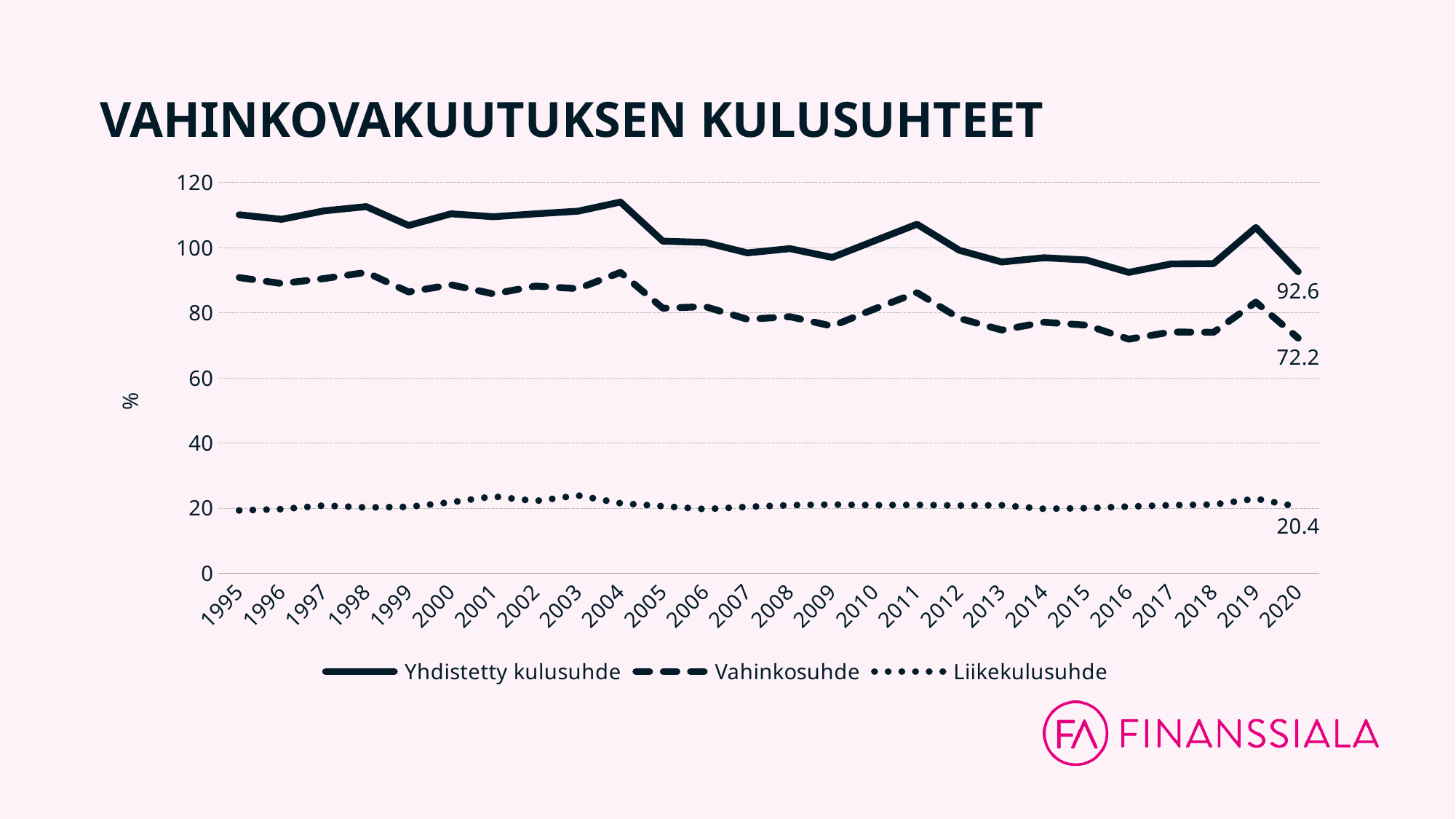
What is the difference between Vahinkosuhde and Liikekulusuhde in 2020? 51.8 How many series does the legend list? 3 What is the difference between Yhdistetty kulusuhde and Vahinkosuhde in 2020? 20.4 Is the value for Yhdistetty kulusuhde in 2016 greater or less than 100? less In 2020, which is larger: Yhdistetty kulusuhde or Vahinkosuhde? Yhdistetty kulusuhde What is the value of Yhdistetty kulusuhde in 2020? 92.6 How many years are shown on the x axis? 26 What is the value of Vahinkosuhde in 2020? 72.2 What is the value of Liikekulusuhde in 2020? 20.4 Is the value for Yhdistetty kulusuhde in 2004 greater or less than 100? greater What kind of chart is shown on the slide? line chart Is the value for Vahinkosuhde in 2016 greater or less than 80? less